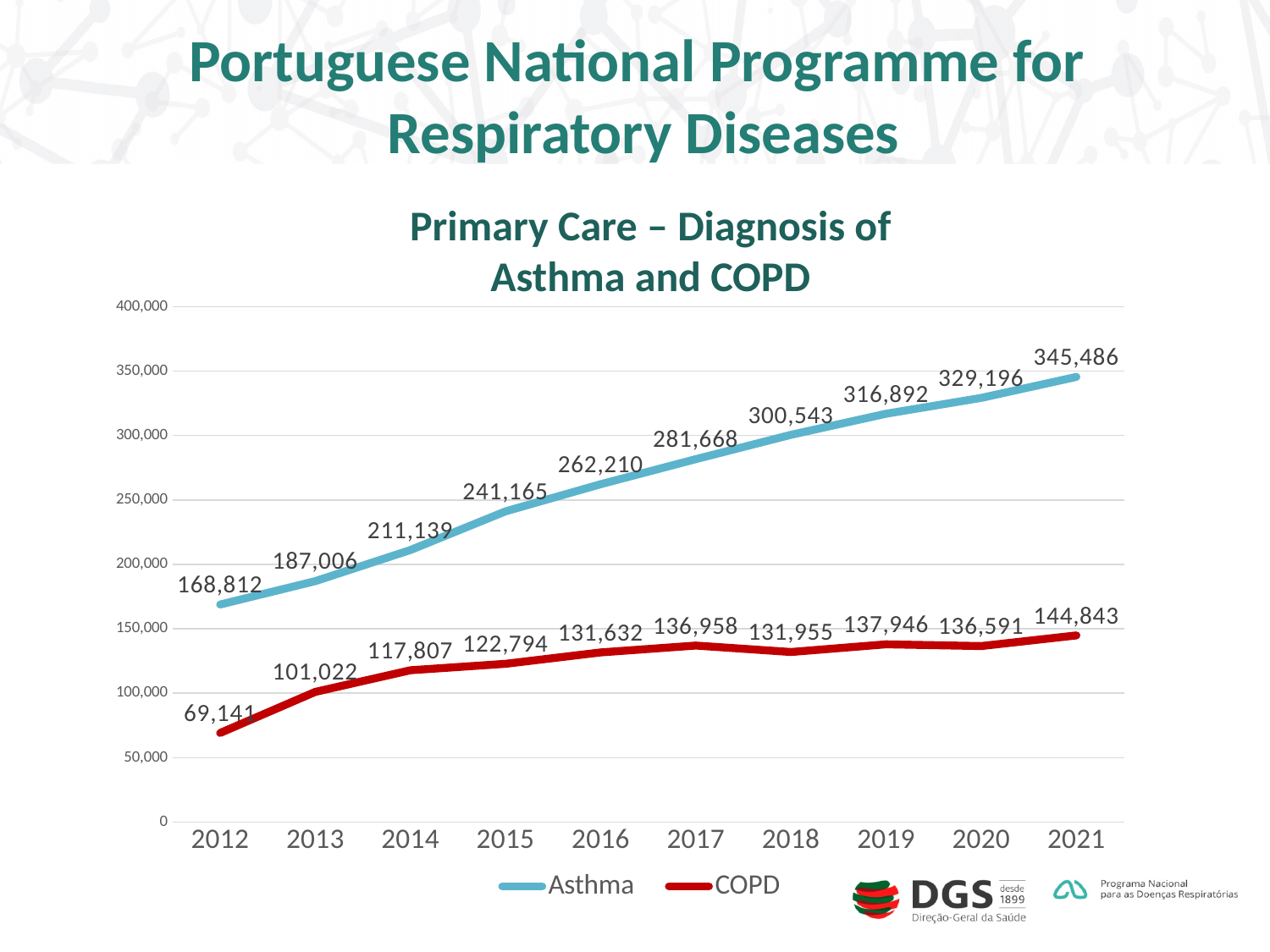
How many series does the legend list? 2 What is the COPD value for 2013? 101,022 In which year is the COPD value lowest? 2012 What is the Asthma value for 2016? 262,210 What is the Asthma value for 2021? 345,486 How many years are shown on the x axis? 10 What is the difference between the Asthma values for 2021 and 2012? 176,674 In which year is the Asthma value highest? 2021 Which is larger, the COPD value for 2017 or for 2018? 2017 What kind of chart is shown on the slide? line chart What is the difference between the Asthma and COPD values in 2021? 200,643 Is the Asthma value for 2018 greater or less than 250,000? greater